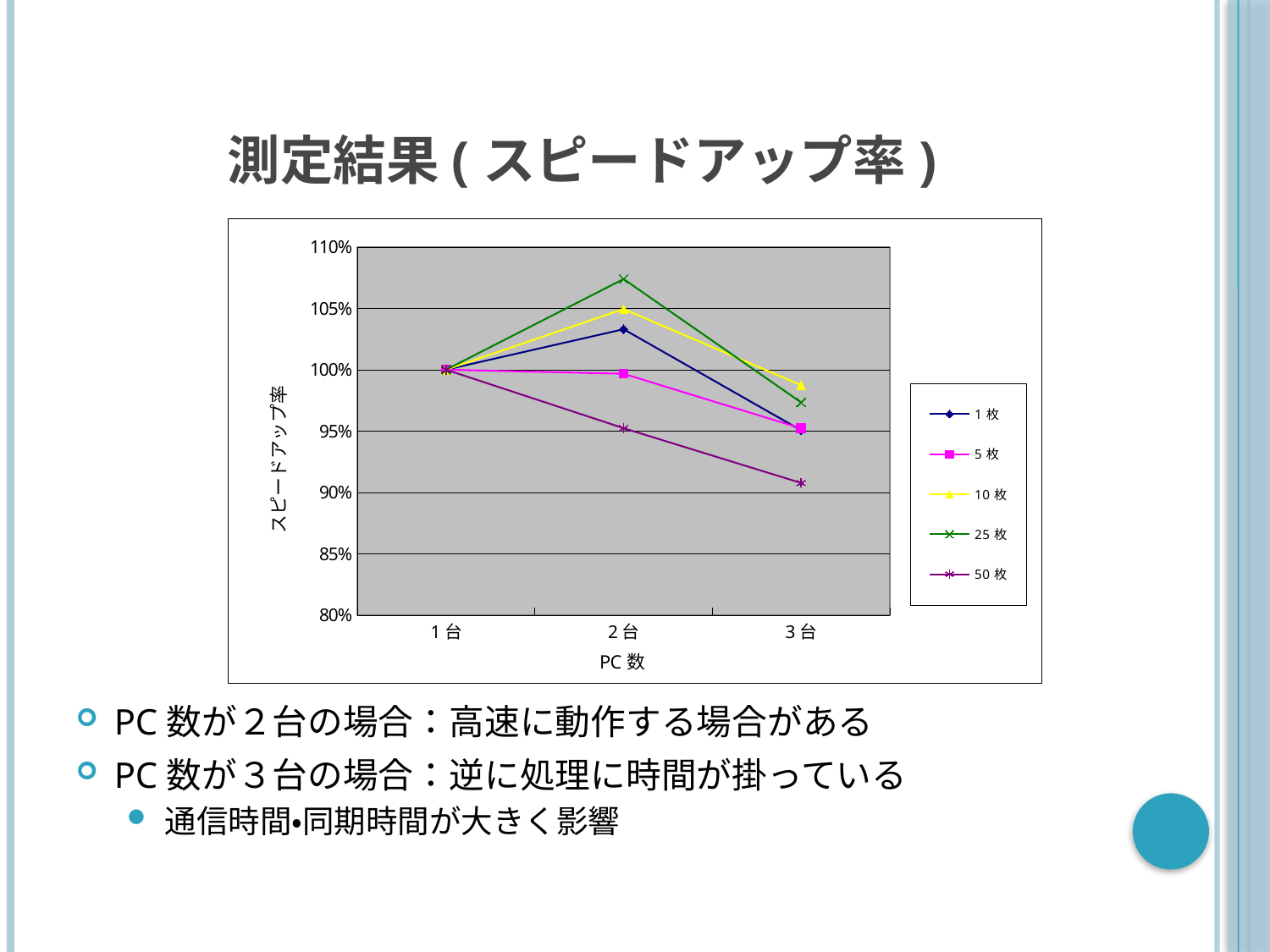
What is the title of the y axis? スピードアップ率 Is the value for 50枚 at 3台 greater or less than 95%? less Is the value for 25枚 at 2台 greater or less than 105%? greater At 2台, which is larger: the value for 25枚 or the value for 1枚? 25枚 Which series has the lowest value at 3台? 50枚 What kind of chart is shown on the slide? line chart What is the value for 25枚 at 1台? 100% Which series has the highest value at 2台? 25枚 How many categories are on the x axis? 3 Is the value for 1枚 at 2台 greater or less than 100%? greater How many series does the legend list? 5 Do the values for 50枚 rise or fall as the number of PCs increases from 1台 to 3台? fall